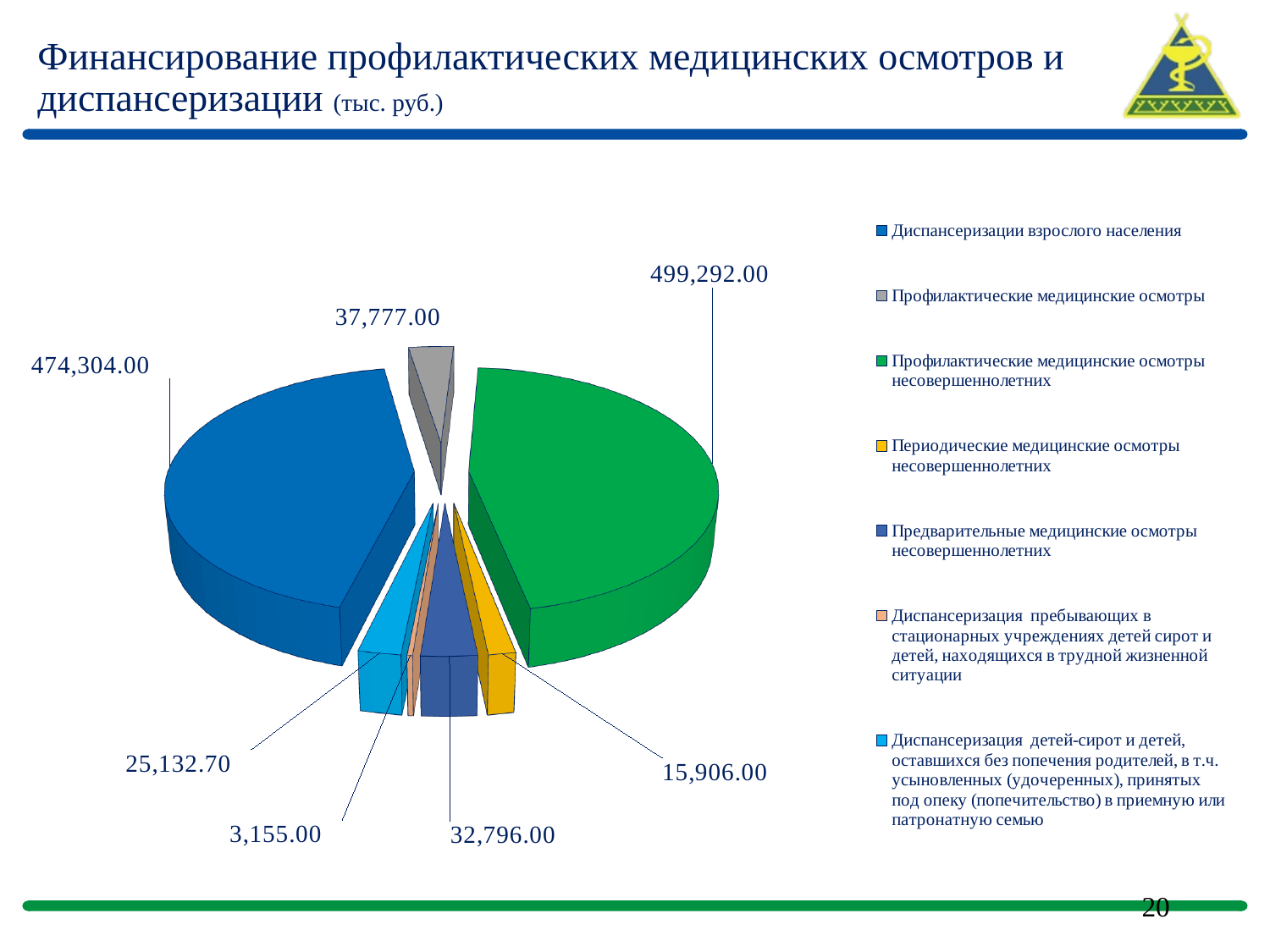
What is the value for Профилактические медицинские осмотры несовершеннолетних? 499,292.00 Which category has the largest slice of the pie? Профилактические медицинские осмотры несовершеннолетних What is the value for Периодические медицинские осмотры несовершеннолетних? 15,906.00 Which category has the smallest slice of the pie? Диспансеризация пребывающих в стационарных учреждениях детей сирот и детей, находящихся в трудной жизненной ситуации What is the difference between the values for Профилактические медицинские осмотры несовершеннолетних and Диспансеризации взрослого населения? 24,988.00 What is the value for Диспансеризации взрослого населения? 474,304.00 What is the value for Диспансеризация пребывающих в стационарных учреждениях детей сирот и детей, находящихся в трудной жизненной ситуации? 3,155.00 How many slices does the pie chart have? 7 What is the value for Профилактические медицинские осмотры? 37,777.00 Which is larger: the value for Предварительные медицинские осмотры несовершеннолетних or the value for Периодические медицинские осмотры несовершеннолетних? Предварительные медицинские осмотры несовершеннолетних How many entries does the legend list? 7 What type of chart is shown on the slide? pie chart